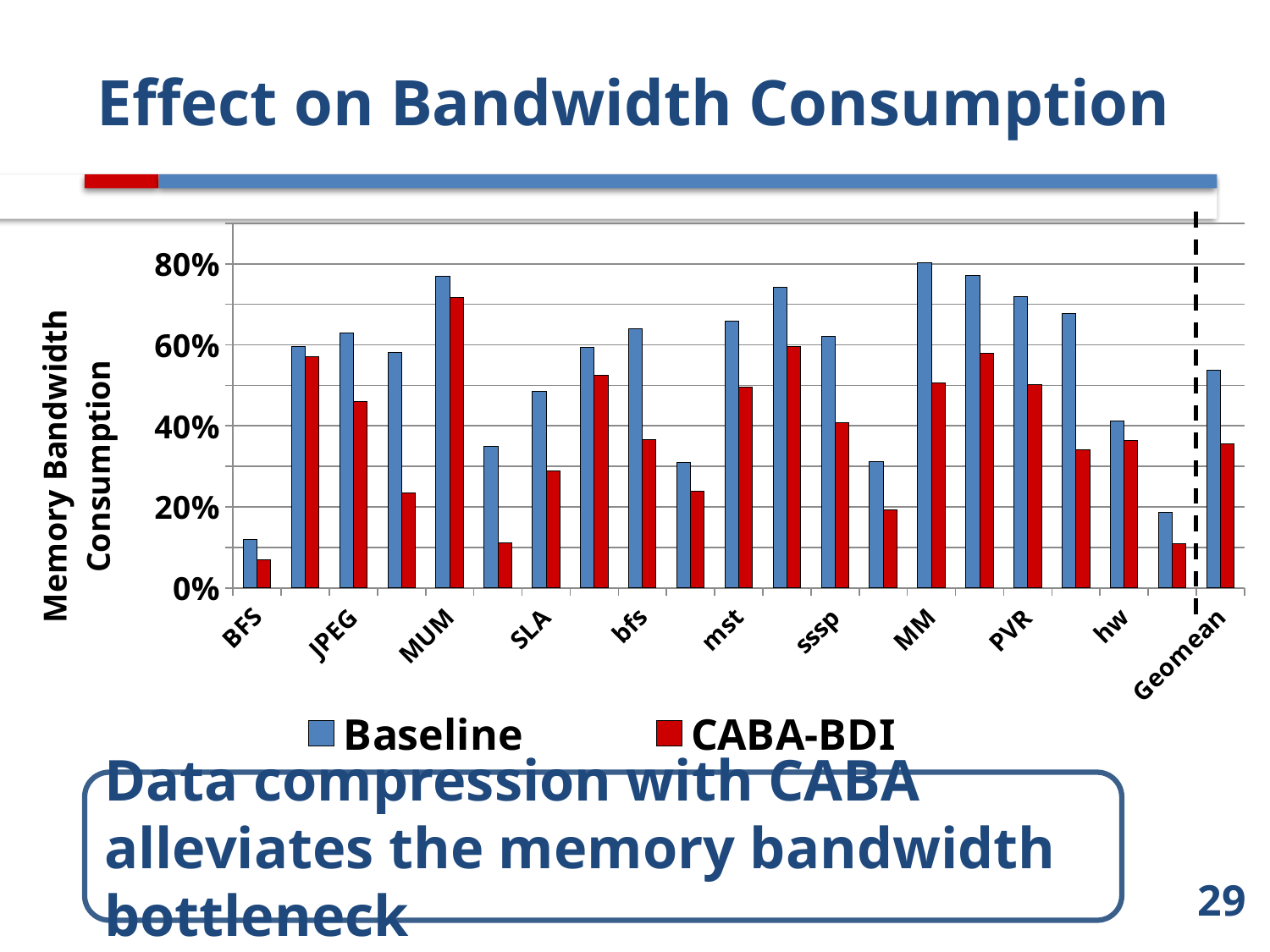
What is the y-axis label of the chart? Memory Bandwidth Consumption Is the Baseline value for hw greater or less than 60%? less Is the CABA-BDI value for MUM greater or less than 60%? greater What kind of chart is shown on the slide? bar chart What are the two series named in the legend? Baseline and CABA-BDI How many series does the legend list? 2 Is the CABA-BDI value for SLA greater or less than 40%? less Which labeled category has the lowest Baseline value? BFS For Geomean, which series has the larger value, Baseline or CABA-BDI? Baseline